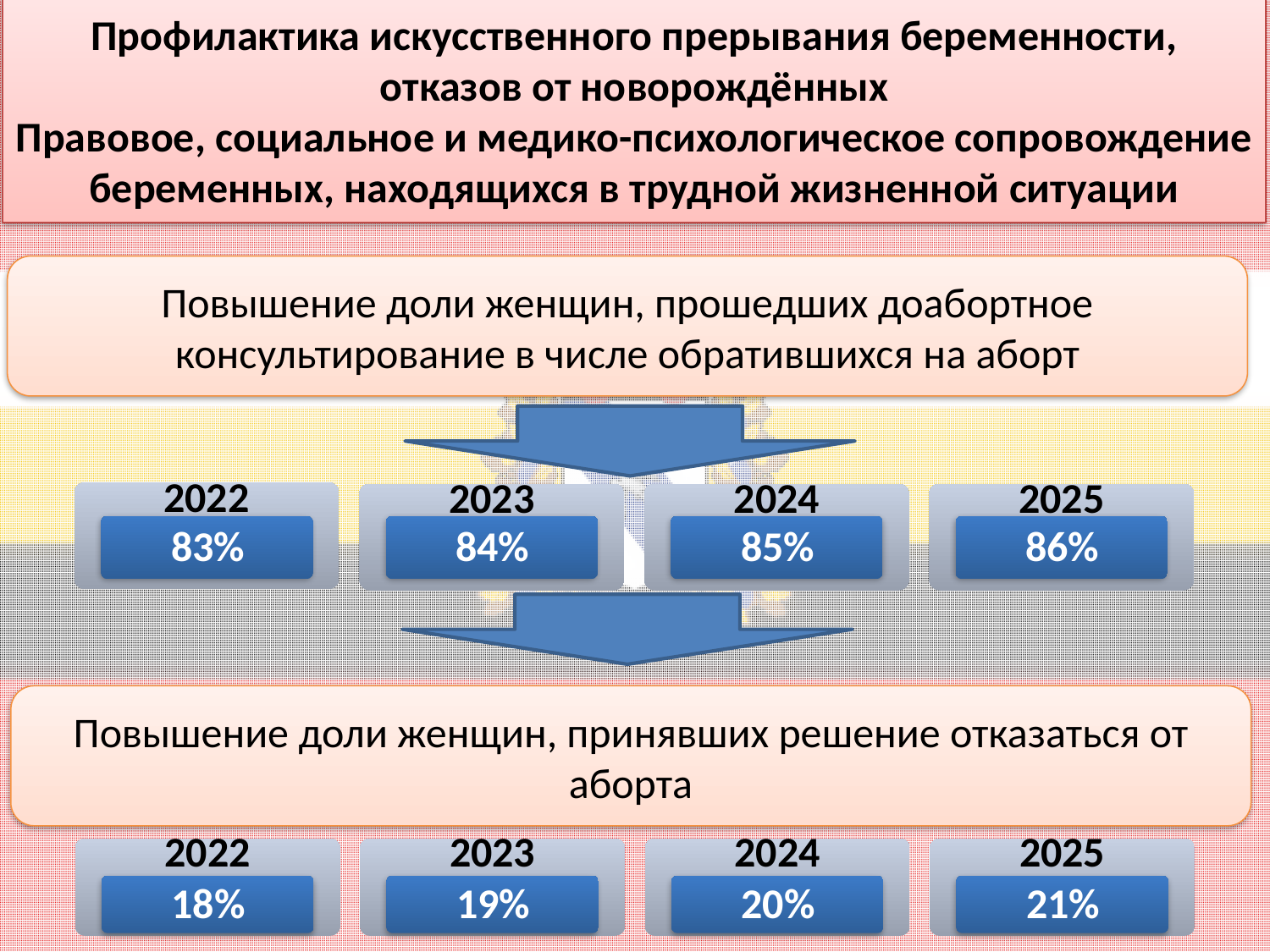
In the lower diagram ("Повышение доли женщин, принявших решение отказаться от аборта"), what is the value for 2025? 21% In the lower diagram, do the values rise or fall from 2022 to 2025? rise In the upper diagram, what is the difference between the values for 2025 and 2022? 3% In the upper diagram ("Повышение доли женщин, прошедших доабортное консультирование в числе обратившихся на аборт"), what is the value for 2022? 83% In the lower diagram, which year has the lowest value? 2022 In the upper diagram, which year has the highest value? 2025 In the lower diagram, what is the difference between the values for 2024 and 2022? 2% In the upper diagram ("Повышение доли женщин, прошедших доабортное консультирование..."), what is the value for 2024? 85% In the lower diagram ("Повышение доли женщин, принявших решение отказаться от аборта"), what is the value for 2023? 19% In the lower diagram, which is larger: the value for 2023 or the value for 2025? 2025 In the upper diagram, do the values rise or fall from 2022 to 2025? rise How many years are shown in the upper diagram? 4